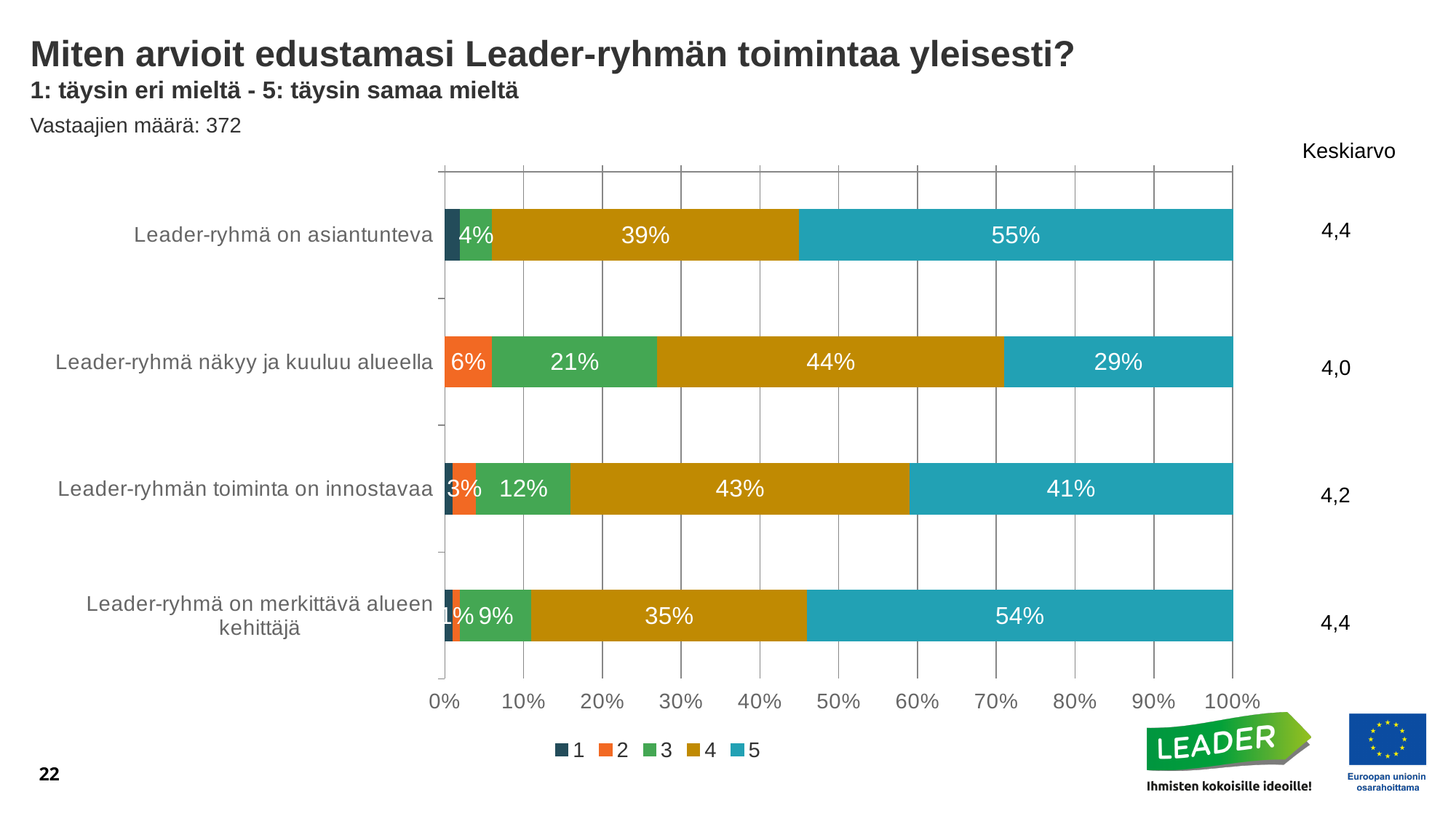
How many categories (statements) are plotted in the chart? 4 Which statement has the highest share of respondents giving a 3? Leader-ryhmä näkyy ja kuuluu alueella What percentage of respondents gave a 3 for "Leader-ryhmän toiminta on innostavaa"? 12% What kind of chart is shown on the slide? Stacked bar chart How many series does the legend list? 5 Which is larger: the share of 4 ratings for "Leader-ryhmä on asiantunteva" or for "Leader-ryhmä on merkittävä alueen kehittäjä"? Leader-ryhmä on asiantunteva What is the difference between the share of 5 ratings for "Leader-ryhmä on asiantunteva" and for "Leader-ryhmä näkyy ja kuuluu alueella"? 26 percentage points What percentage of respondents gave a 4 for "Leader-ryhmä näkyy ja kuuluu alueella"? 44% What percentage of respondents gave a 5 for "Leader-ryhmä on asiantunteva"? 55% What is the Keskiarvo (average) shown for "Leader-ryhmä näkyy ja kuuluu alueella"? 4,0 What percentage of respondents gave a 2 for "Leader-ryhmä on merkittävä alueen kehittäjä"? 1% Which statement has the lowest share of respondents giving a 5? Leader-ryhmä näkyy ja kuuluu alueella